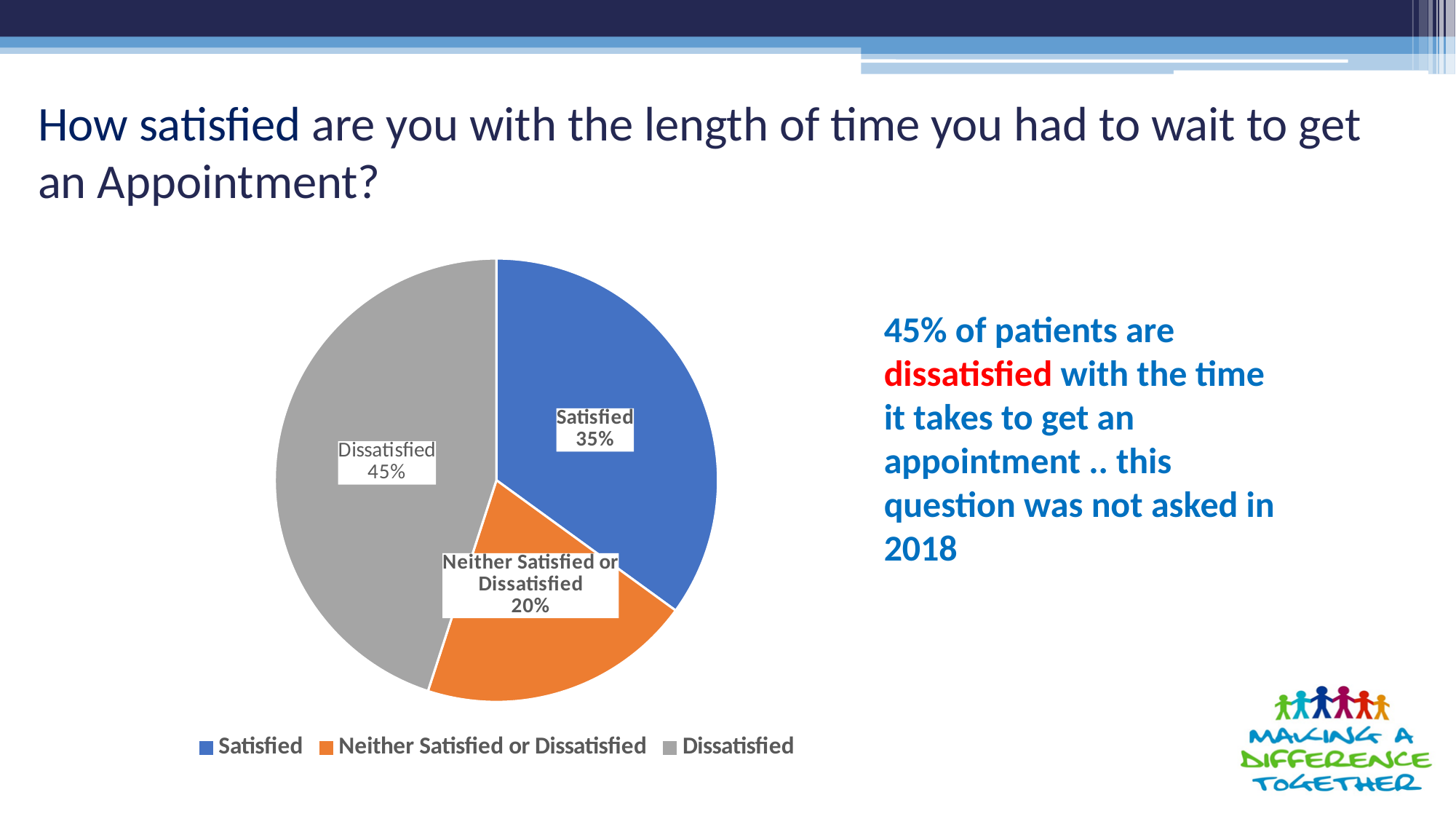
What is the difference in percentage points between the Dissatisfied and Satisfied slices? 10 What colour is the Dissatisfied slice? Grey What kind of chart is shown on the slide? Pie chart What percentage of respondents are Dissatisfied? 45% Which category has the largest share of the pie? Dissatisfied How many entries does the legend list? 3 Which category has the smallest share of the pie? Neither Satisfied or Dissatisfied How many categories does the pie chart show? 3 What colour is the Neither Satisfied or Dissatisfied slice? Orange What percentage of respondents are Neither Satisfied or Dissatisfied? 20% Which is larger, the Satisfied slice or the Neither Satisfied or Dissatisfied slice? Satisfied What percentage of respondents are Satisfied with the length of time they had to wait to get an appointment? 35%